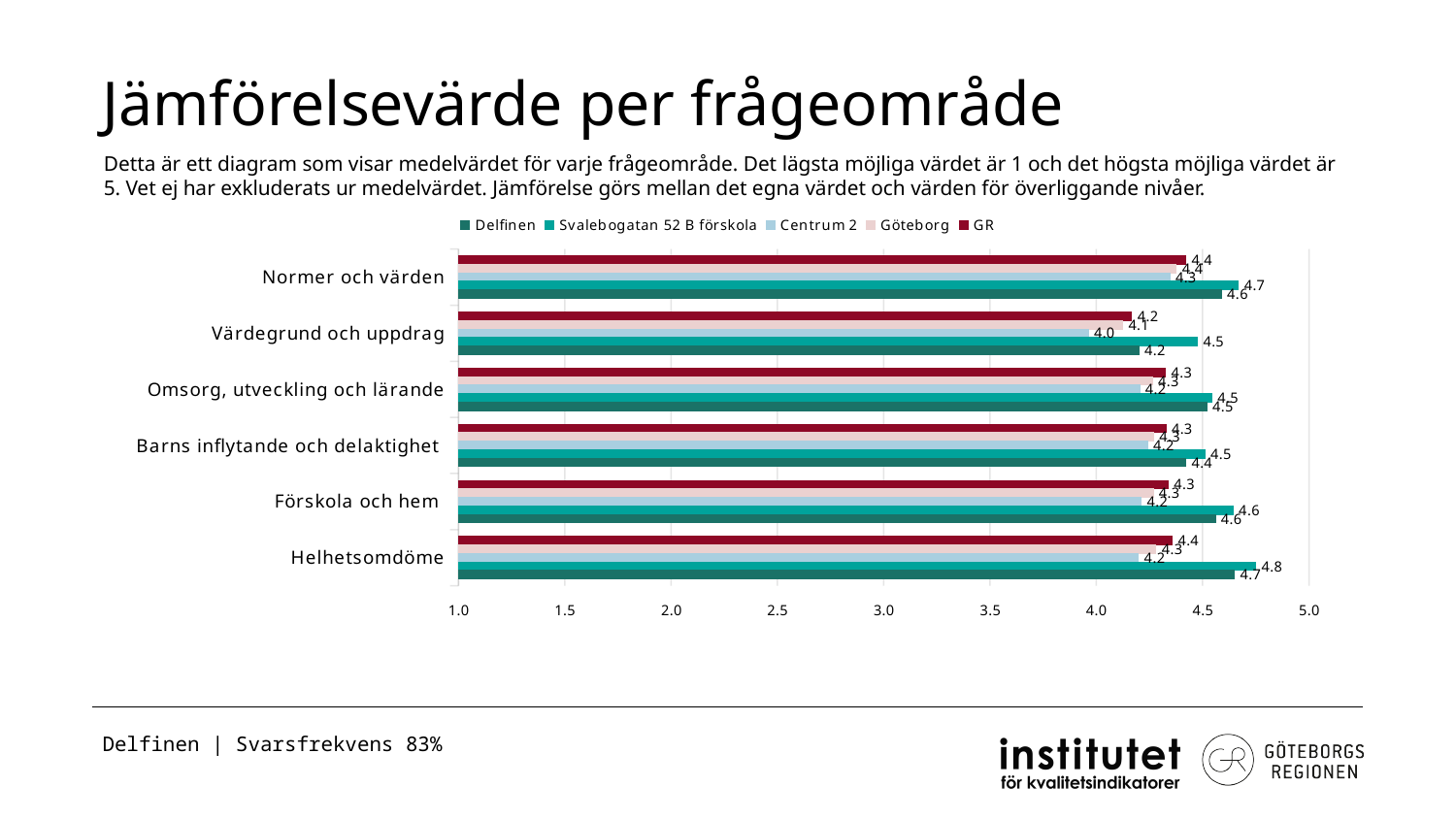
How many series does the legend list? 5 What is the value for Centrum 2 in Värdegrund och uppdrag? 4.0 In which category does Svalebogatan 52 B förskola have its highest value? Helhetsomdöme In which category does Centrum 2 have its lowest value? Värdegrund och uppdrag What is the value for Svalebogatan 52 B förskola in Helhetsomdöme? 4.8 What is the difference between Svalebogatan 52 B förskola and Centrum 2 in Värdegrund och uppdrag? 0.5 What is the value for Delfinen in Helhetsomdöme? 4.7 Is the value for Delfinen in Värdegrund och uppdrag greater or less than 4.5? less How many question areas (categories) are shown on the y axis? 6 In Normer och värden, which is larger: the value for Svalebogatan 52 B förskola or the value for Centrum 2? Svalebogatan 52 B förskola What kind of chart is shown on the slide? Bar chart What is the value for Svalebogatan 52 B förskola in Värdegrund och uppdrag? 4.5